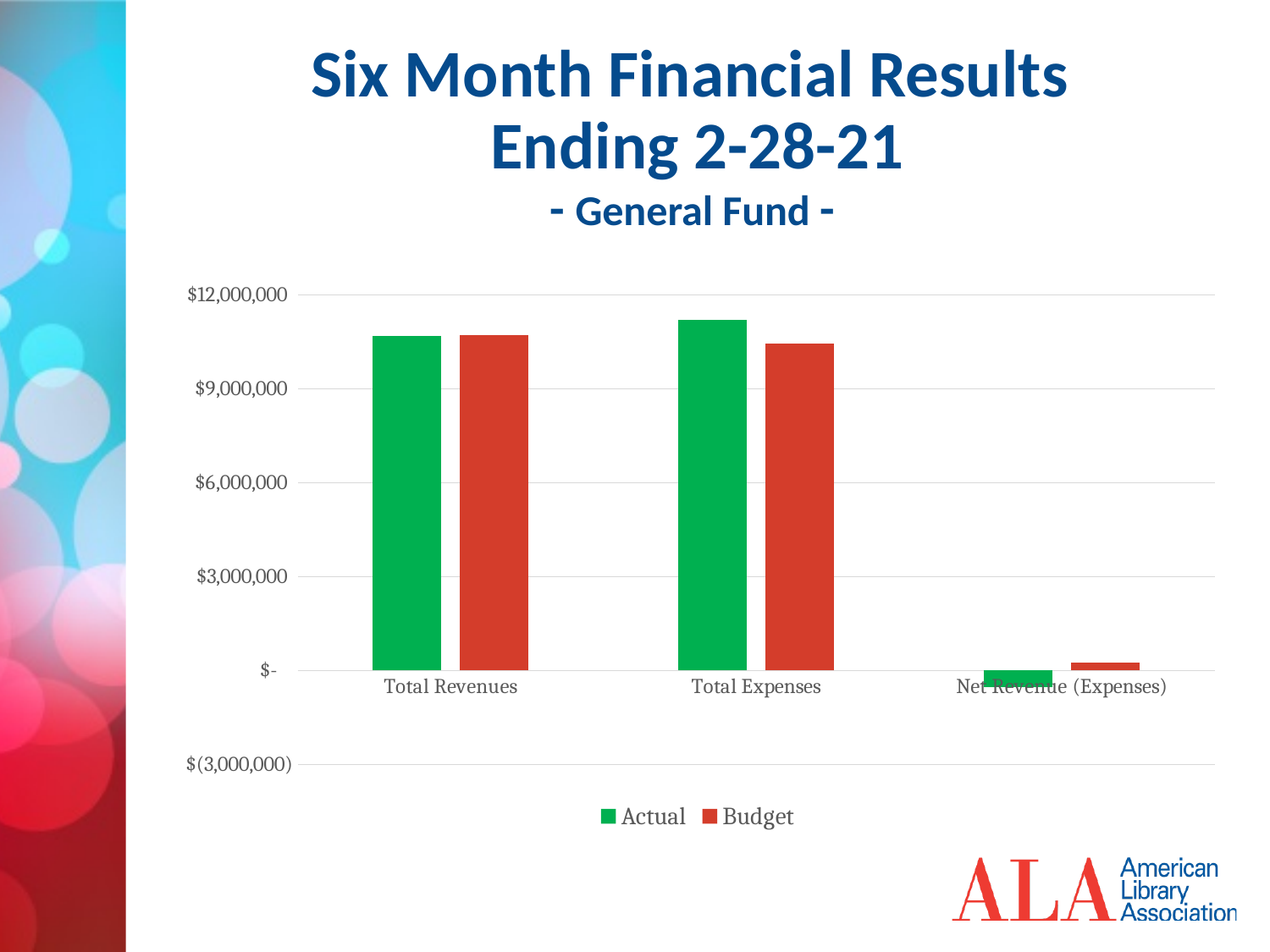
How many categories are shown on the x axis of the chart? 3 Which colour represents the Actual series in the chart? green Is the Budget value for Net Revenue (Expenses) greater or less than $3,000,000? less For Total Expenses, which is larger, the Actual bar or the Budget bar? Actual Is the Actual value for Total Revenues greater or less than $9,000,000? greater Which is larger for the Actual series, Total Revenues or Total Expenses? Total Expenses Which category has the lowest Actual value? Net Revenue (Expenses) Is the Actual value for Total Expenses greater or less than $9,000,000? greater What kind of chart is shown on the slide? bar chart Which series are listed in the chart legend? Actual and Budget Which category has the highest Actual value? Total Expenses How many series does the chart legend list? 2